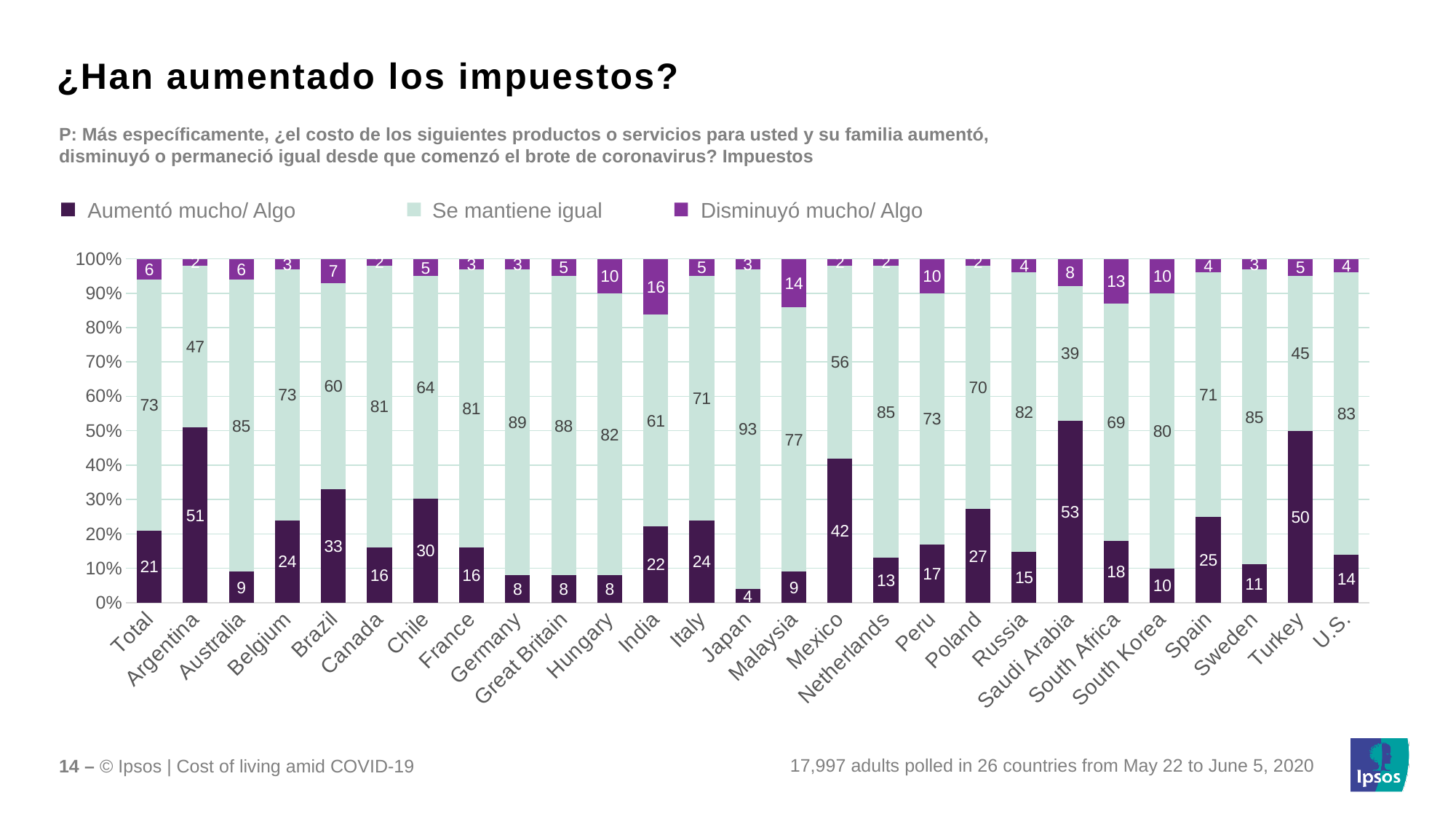
Which country has the lowest 'Aumentó mucho/ Algo' value? Japan How many series does the legend list? 3 Which country has the highest 'Aumentó mucho/ Algo' value? Saudi Arabia What is the 'Aumentó mucho/ Algo' value for Total? 21 How many categories are shown on the x axis? 27 What percentage of respondents in Saudi Arabia said taxes 'Aumentó mucho/ Algo'? 53 Which has a larger 'Aumentó mucho/ Algo' value, Mexico or Brazil? Mexico What is the 'Disminuyó mucho/ Algo' value for India? 16 Which country has the highest 'Disminuyó mucho/ Algo' value? India What is the difference between the 'Aumentó mucho/ Algo' values for Argentina and Turkey? 1 What kind of chart is shown on the slide? Stacked bar chart What is the 'Se mantiene igual' value for Japan? 93